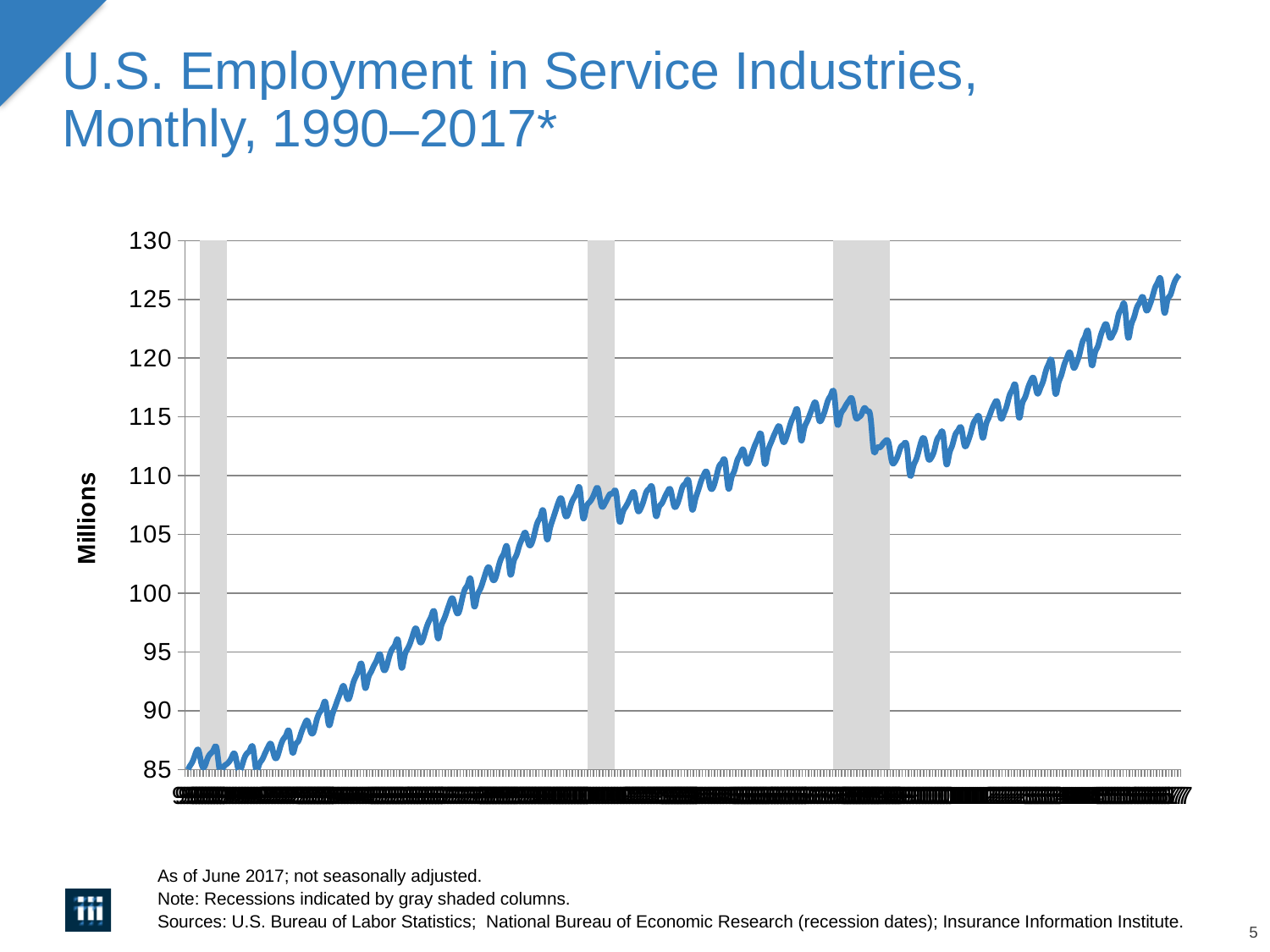
What kind of chart is shown on the slide? line chart Is the peak reached just before the third gray recession column greater or less than 115? greater Overall, do the values rise or fall from 1990 to 2017? rise Is the value at the end of the series in 2017 greater or less than 125? greater How many gray shaded recession columns are shown on the chart? 3 What is the label on the vertical axis? Millions Is the value during the first gray recession column greater or less than 90? less What is the highest value shown on the vertical axis? 130 Does the line end higher or lower than where it starts? higher